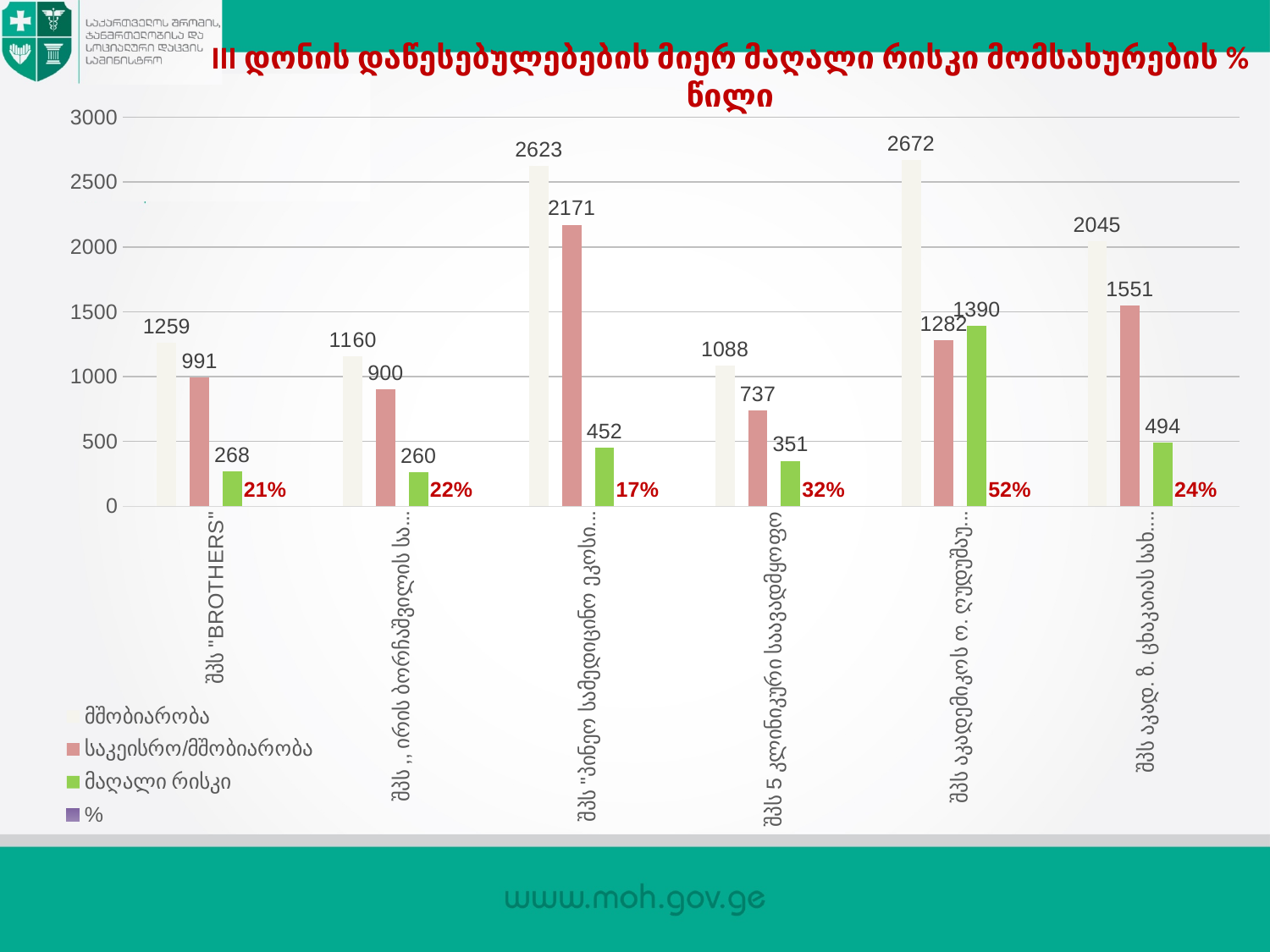
What is the მშობიარობა value for შპს "BROTHERS"? 1259 What is the საკეისრო/მშობიარობა value for შპს 5 კლინიკური საავადმყოფო? 737 Which category has the highest მშობიარობა value? შპს აკადემიკოს ო. ღუდუშაუ... What colour are the მაღალი რისკი bars? green What is the difference between the მშობიარობა and საკეისრო/მშობიარობა values for შპს "BROTHERS"? 268 Which category has the lowest მაღალი რისკი value? შპს ,, ირის ბორჩაშვილის სა... How many series does the legend list? 4 What percentage label is shown for შპს 5 კლინიკური საავადმყოფო? 32% What type of chart is shown on the slide? bar chart How many categories (hospitals) are shown on the x axis? 6 Which is larger for შპს აკადემიკოს ო. ღუდუშაუ...: the საკეისრო/მშობიარობა value or the მაღალი რისკი value? მაღალი რისკი (1390) Which category has the highest percentage label? შპს აკადემიკოს ო. ღუდუშაუ... (52%)